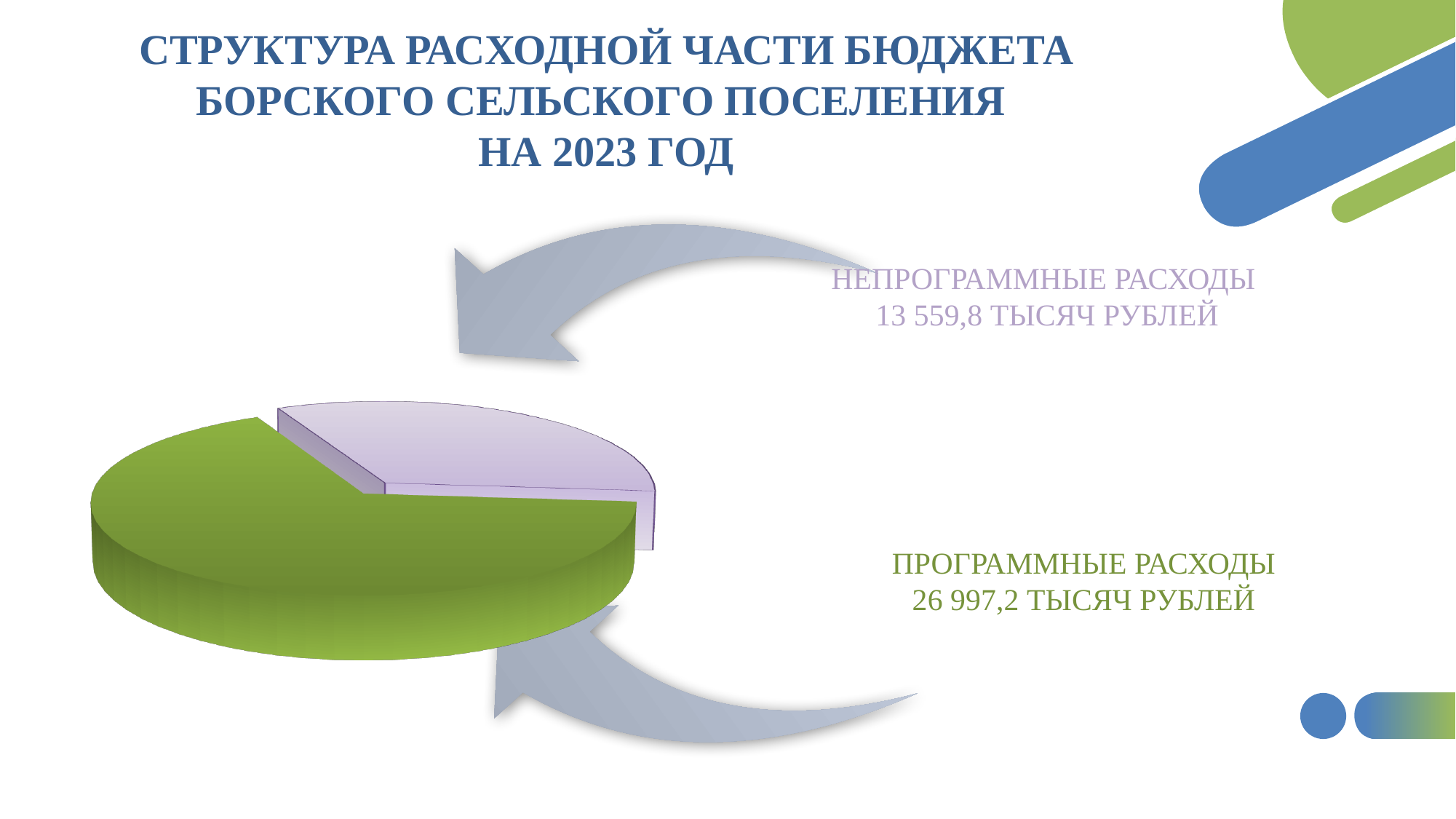
What is the total of the two categories shown in the pie chart, in тысяч рублей? 40 557,0 Which category has the smallest slice of the pie? НЕПРОГРАММНЫЕ РАСХОДЫ What is the value for ПРОГРАММНЫЕ РАСХОДЫ? 26 997,2 тысяч рублей What is the value for НЕПРОГРАММНЫЕ РАСХОДЫ? 13 559,8 тысяч рублей What colour is the slice for ПРОГРАММНЫЕ РАСХОДЫ? Green What year does the chart title refer to? 2023 How many categories does the pie chart show? 2 Which is larger: ПРОГРАММНЫЕ РАСХОДЫ or НЕПРОГРАММНЫЕ РАСХОДЫ? ПРОГРАММНЫЕ РАСХОДЫ What is the difference between ПРОГРАММНЫЕ РАСХОДЫ and НЕПРОГРАММНЫЕ РАСХОДЫ, in тысяч рублей? 13 437,4 What kind of chart is shown on the slide? Pie chart Which category has the largest slice of the pie? ПРОГРАММНЫЕ РАСХОДЫ